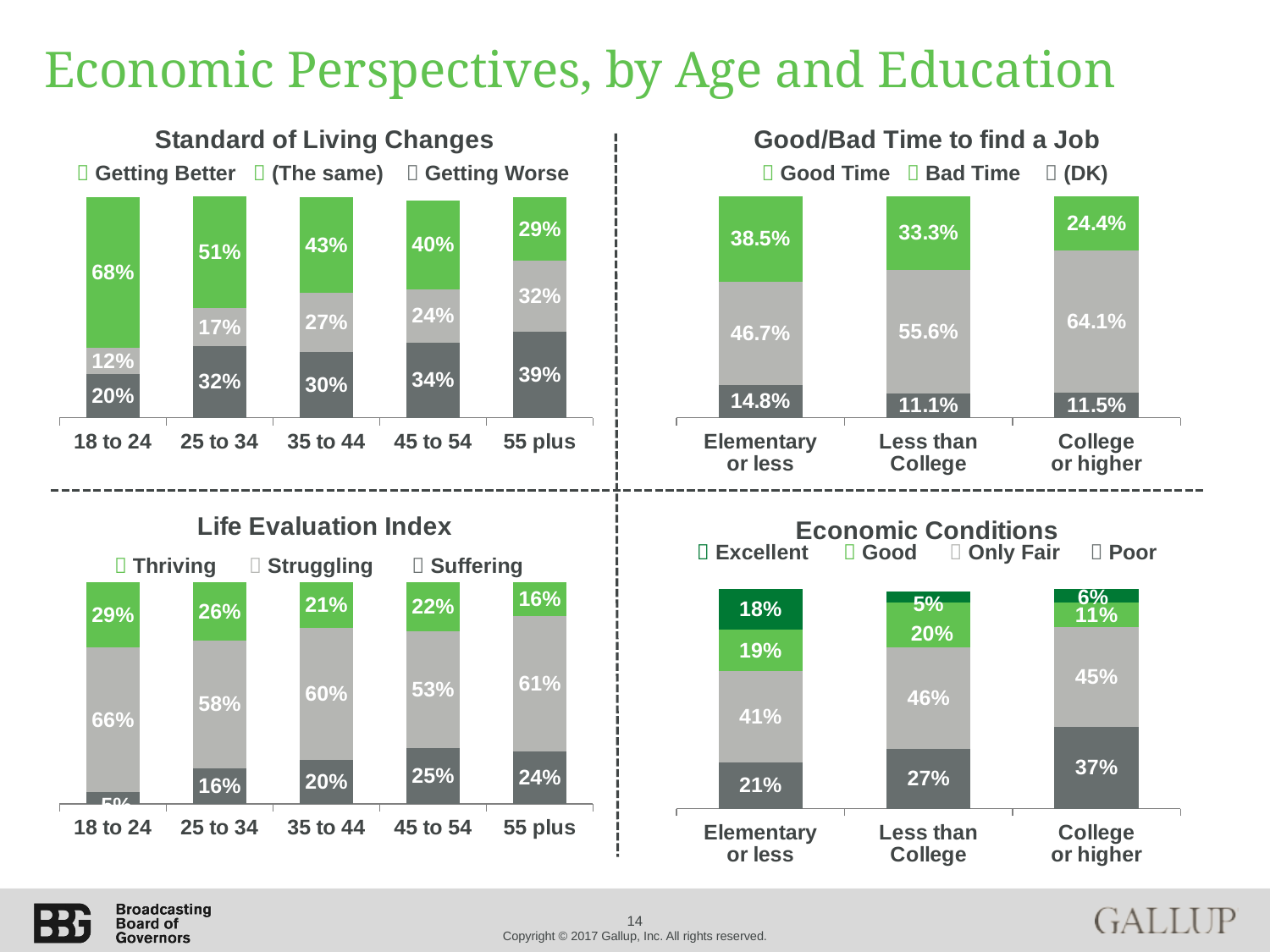
In the Standard of Living Changes chart, does the Getting Better share rise or fall as age increases from 18 to 24 to 55 plus? Fall In the Good/Bad Time to find a Job chart, what is the difference between the Bad Time values for College or higher and Elementary or less? 17.4 percentage points In the Life Evaluation Index chart, how many percentage points higher is Struggling for 18 to 24 than for 45 to 54? 13 percentage points How many age groups are shown in the Life Evaluation Index chart? 5 In the Standard of Living Changes chart, which age group has the highest Getting Better share? 18 to 24 How many series does the legend of the Economic Conditions chart list? 4 In the Standard of Living Changes chart, what percentage of the 18 to 24 group say things are Getting Better? 68% What kind of chart is the Good/Bad Time to find a Job chart? Stacked bar chart In the Good/Bad Time to find a Job chart, which education group has the lowest Good Time value? College or higher In the Good/Bad Time to find a Job chart, what is the Bad Time value for College or higher? 64.1% In the Economic Conditions chart, what is the Only Fair value for Less than College? 46% In the Economic Conditions chart, which has the larger Poor value: College or higher or Elementary or less? College or higher